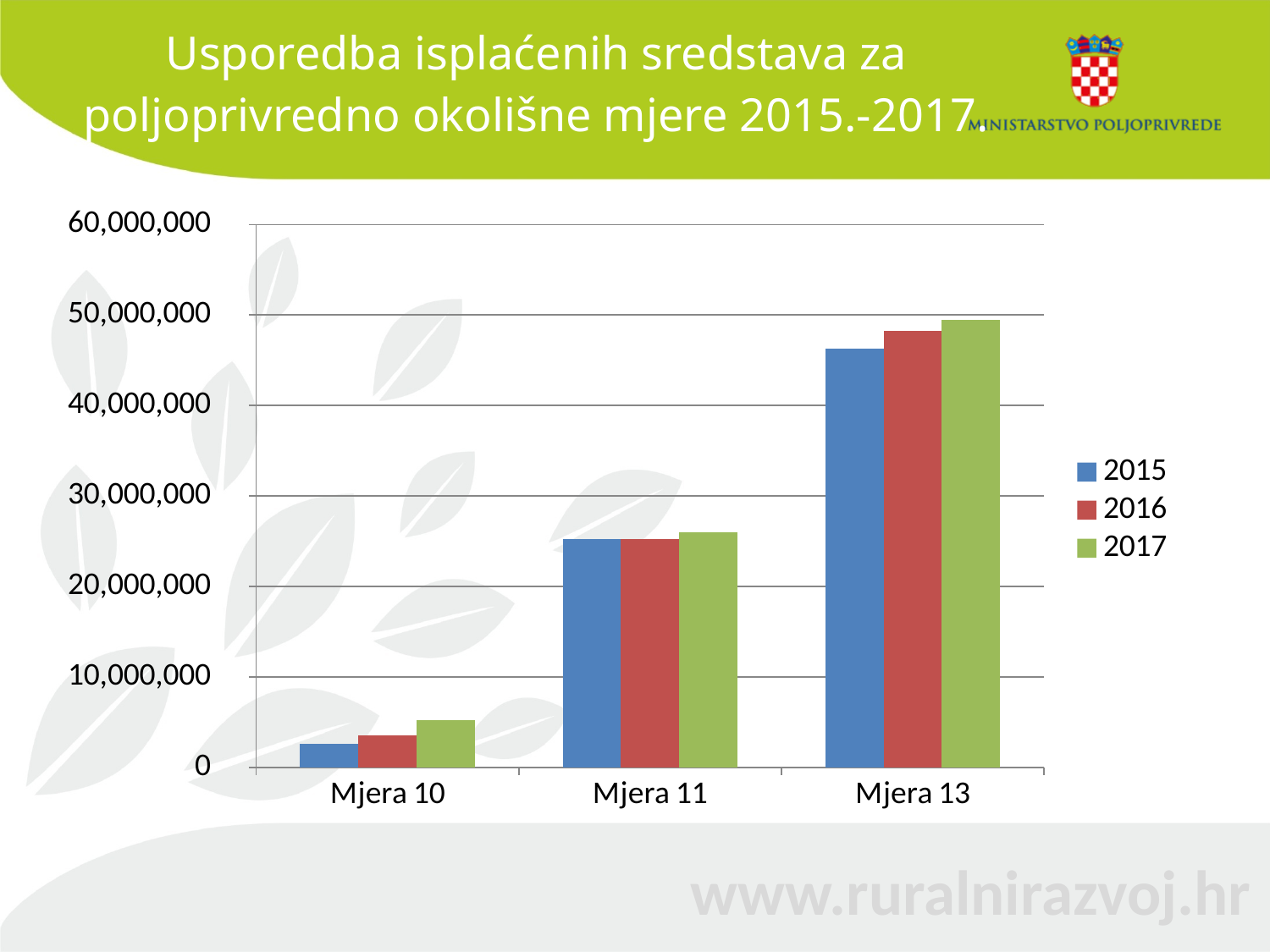
Which is larger for 2017: Mjera 11 or Mjera 13? Mjera 13 How many categories are shown on the x axis? 3 Which category has the lowest value for 2015? Mjera 10 Which category has the highest value for 2017? Mjera 13 Is the value for Mjera 10 in 2017 greater or less than 10,000,000? less What are the entries listed in the legend? 2015, 2016, 2017 Is the value for Mjera 11 in 2017 greater or less than 30,000,000? less How many series does the legend list? 3 For Mjera 13, do the values rise or fall from 2015 to 2017? rise Is the value for Mjera 11 in 2016 greater or less than 20,000,000? greater What kind of chart is shown on the slide? bar chart